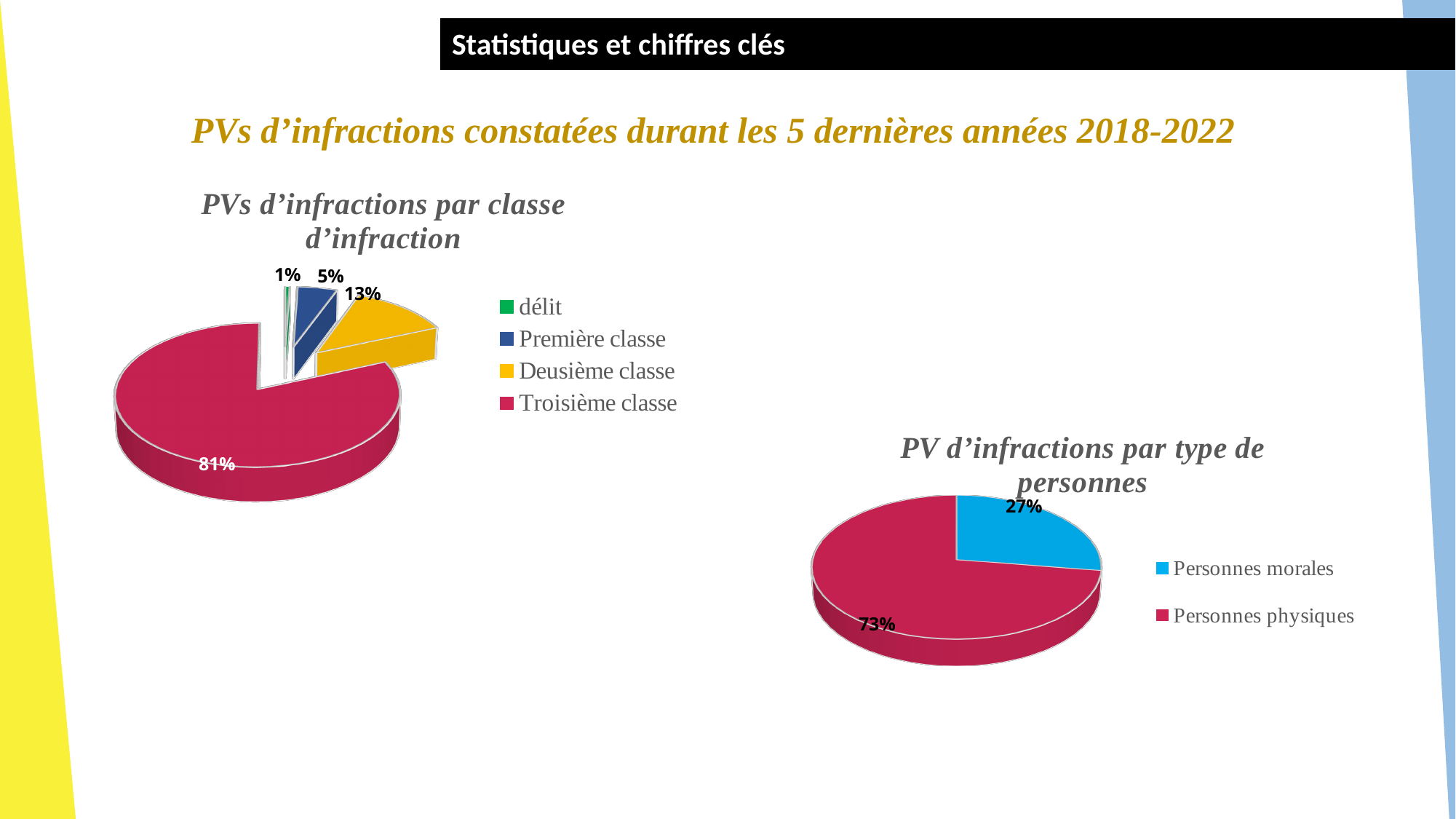
In the chart 'PVs d'infractions par classe d'infraction', which category has the smallest share? délit In the chart 'PV d'infractions par type de personnes', what share do Personnes morales have? 27% In the chart 'PVs d'infractions par classe d'infraction', what is the difference in percentage points between Deusième classe and Première classe? 8 percentage points What type of chart is 'PV d'infractions par type de personnes'? Pie chart In the chart 'PVs d'infractions par classe d'infraction', which category has the largest share? Troisième classe In the chart 'PVs d'infractions par classe d'infraction', what share does Première classe have? 5% In the chart 'PVs d'infractions par classe d'infraction', what share does délit have? 1% In the chart 'PVs d'infractions par classe d'infraction', what share does Troisième classe have? 81% In the chart 'PV d'infractions par type de personnes', what share do Personnes physiques have? 73% In the chart 'PV d'infractions par type de personnes', which category is larger, Personnes morales or Personnes physiques? Personnes physiques In the chart 'PVs d'infractions par classe d'infraction', what share does Deusième classe have? 13% In the chart 'PVs d'infractions par classe d'infraction', how many categories does the legend list? 4